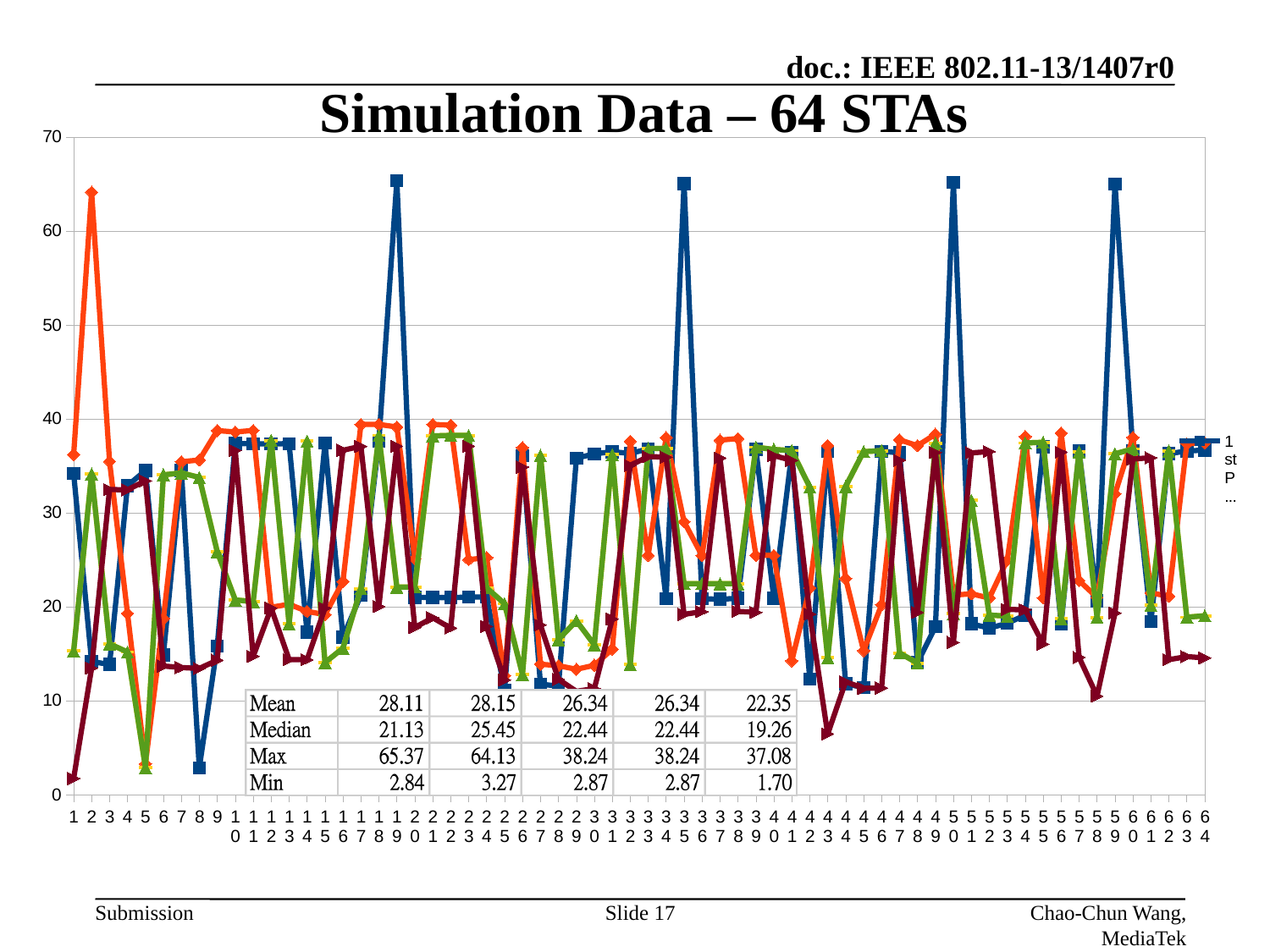
What kind of chart is shown on the slide? line chart At category 2, which series has the larger value, the orange series or the blue series? orange At which category does the orange series reach its highest value? 2 How many categories are shown along the x axis of the chart? 64 What is the highest value shown on the y axis of the chart? 70 Is the value of the orange series at category 1 greater or less than 30? greater Is the value of the blue series at category 8 greater or less than 10? less At category 19, which series has the larger value, the blue series or the green series? blue What is the title of the chart? Simulation Data – 64 STAs Is the value of the orange series at category 2 greater or less than 60? greater